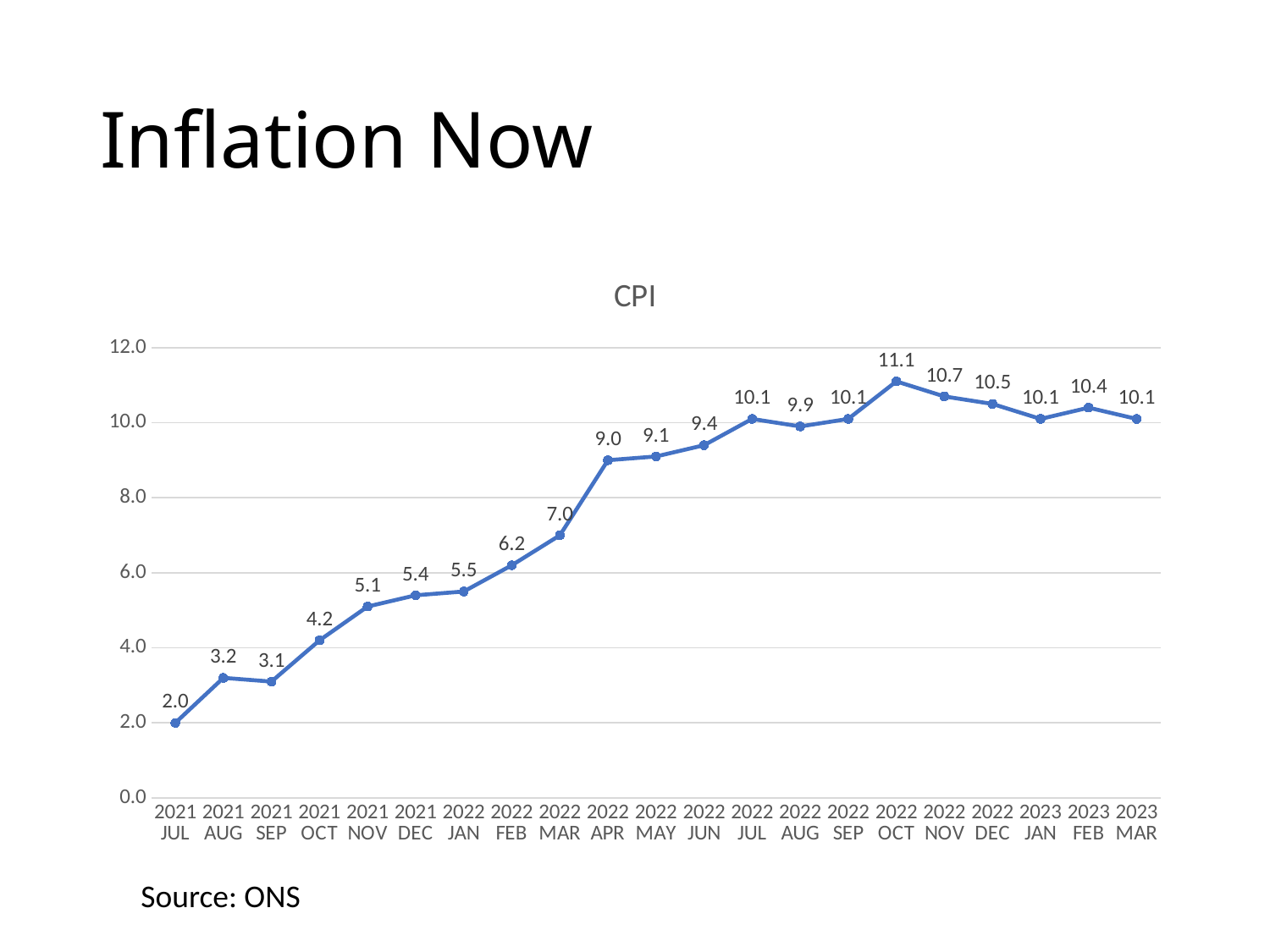
What is the CPI value for 2022 APR? 9.0 Is the CPI value for 2022 JUN greater or less than 8.0? greater How many data points are plotted on the chart? 21 What is the CPI value for 2022 OCT? 11.1 What is the difference between the CPI values for 2022 APR and 2022 MAR? 2.0 Which month has the lowest CPI value? 2021 JUL Which month has the highest CPI value? 2022 OCT What is the CPI value for 2021 JUL? 2.0 Which is larger, the CPI value for 2023 FEB or 2023 MAR? 2023 FEB What kind of chart is shown on the slide? line chart What is the title of the chart? CPI What is the difference between the CPI values for 2022 OCT and 2022 NOV? 0.4